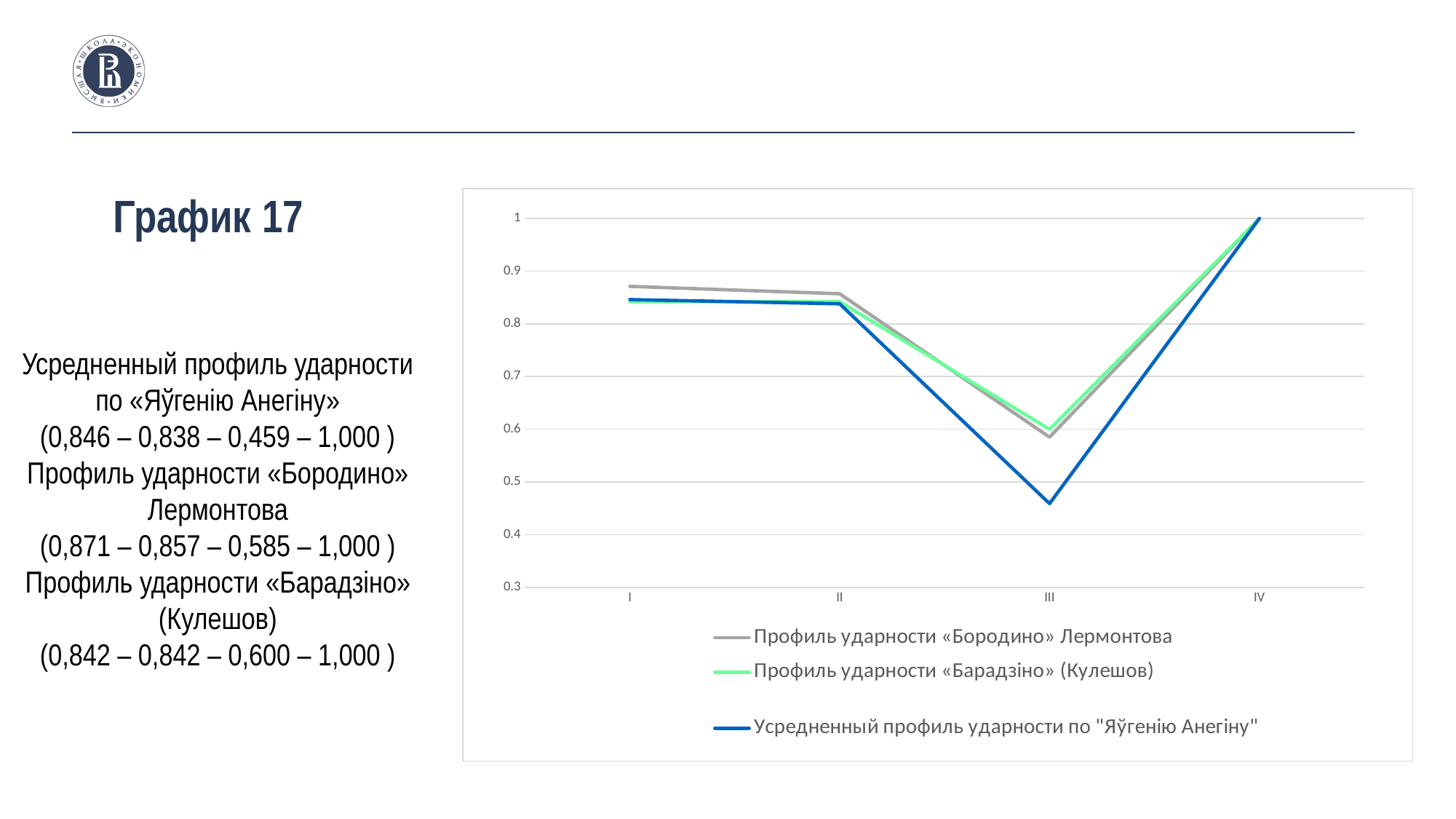
How many series does the legend list? 3 Is the value for «Усредненный профиль ударности по «Яўгенію Анегіну»» at point III greater or less than 0.5? less At which x-axis point does the «Усредненный профиль ударности по «Яўгенію Анегіну»» series reach its lowest value? III Do the values of all three series rise or fall from point II to point III? fall How many points are there along the x axis? 4 What kind of chart is shown on the slide? line chart What is the value of «Усредненный профиль ударности по «Яўгенію Анегіну»» at point III? 0,459 What is the difference between «Профиль ударности «Бородино» Лермонтова» and «Профиль ударности «Барадзіно» (Кулешов)» at point I? 0,029 Is the value for «Профиль ударности «Бородино» Лермонтова» at point I greater or less than 0.8? greater What is the value of «Профиль ударности «Бородино» Лермонтова» at point III? 0,585 At point III, which series has the larger value: «Профиль ударности «Бородино» Лермонтова» or «Усредненный профиль ударности по «Яўгенію Анегіну»»? Профиль ударности «Бородино» Лермонтова What is the value of «Профиль ударности «Барадзіно» (Кулешов)» at point IV? 1,000